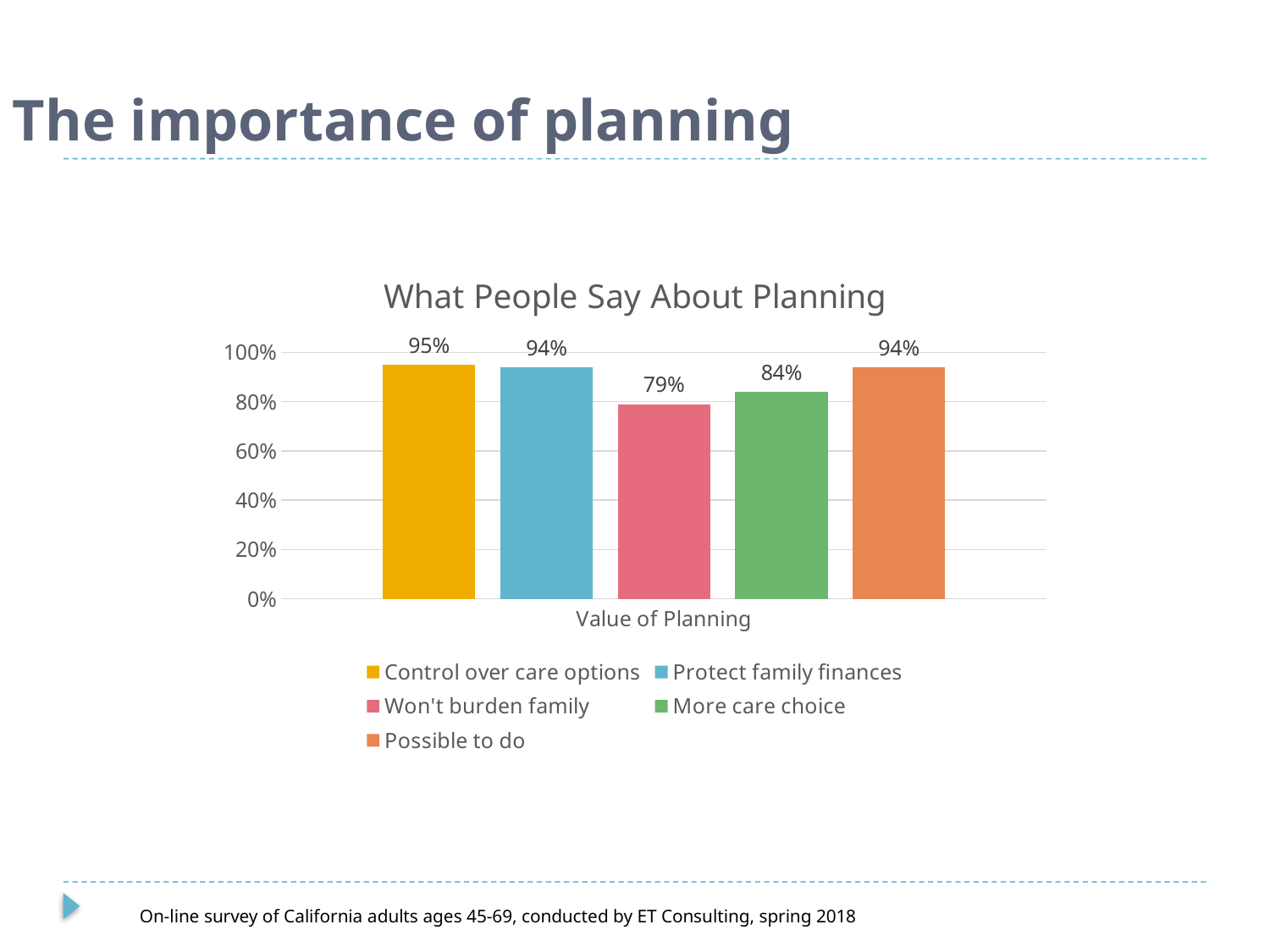
What is the difference between the values for More care choice and Won't burden family? 5% Which is larger, the value for Protect family finances or the value for More care choice? Protect family finances What is the value for Won't burden family? 79% Which series has the lowest value? Won't burden family What is the value for Control over care options? 95% What is the difference between the values for Control over care options and Won't burden family? 16% What kind of chart is shown? Bar chart How many series does the legend list? 5 What is the value for More care choice? 84% Which series has the highest value? Control over care options What is the title of the chart? What People Say About Planning What is the value for Possible to do? 94%